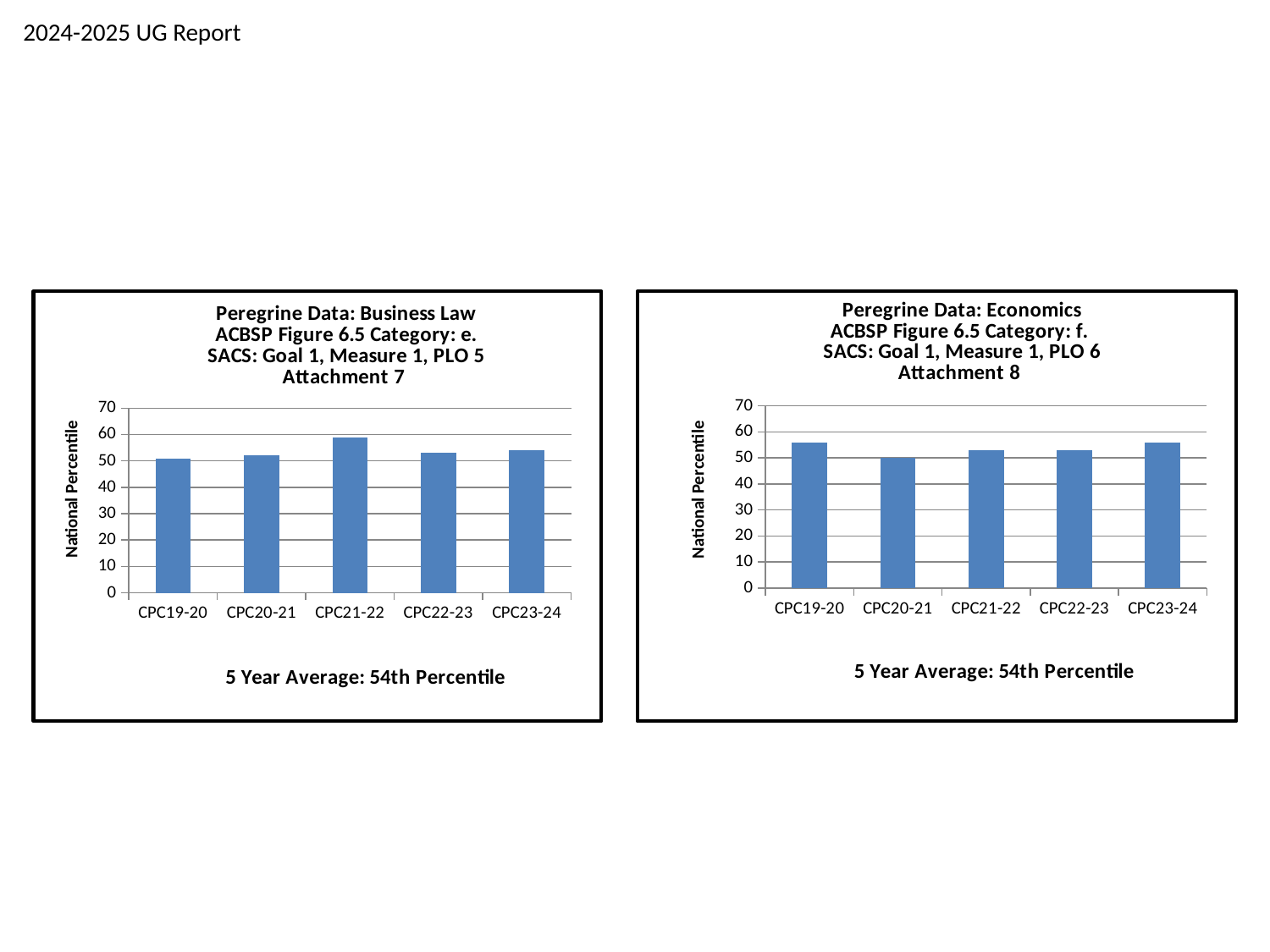
In the Peregrine Data: Business Law chart, is the value for CPC19-20 greater or less than 60? less In the Peregrine Data: Business Law chart, is the value for CPC21-22 greater or less than 50? greater In the Peregrine Data: Business Law chart, which is larger, the value for CPC21-22 or the value for CPC19-20? CPC21-22 What is the y-axis title of the Peregrine Data: Economics chart? National Percentile What 5 year average is stated below the Peregrine Data: Business Law chart? 54th Percentile In the Peregrine Data: Economics chart, is the value for CPC20-21 greater or less than 60? less How many categories are shown on the x axis of the Peregrine Data: Economics chart? 5 In the Peregrine Data: Economics chart, which is larger, the value for CPC19-20 or the value for CPC20-21? CPC19-20 What kind of chart is the Peregrine Data: Business Law chart? bar chart In the Peregrine Data: Business Law chart, which category has the highest national percentile? CPC21-22 In the Peregrine Data: Economics chart, which category has the lowest national percentile? CPC20-21